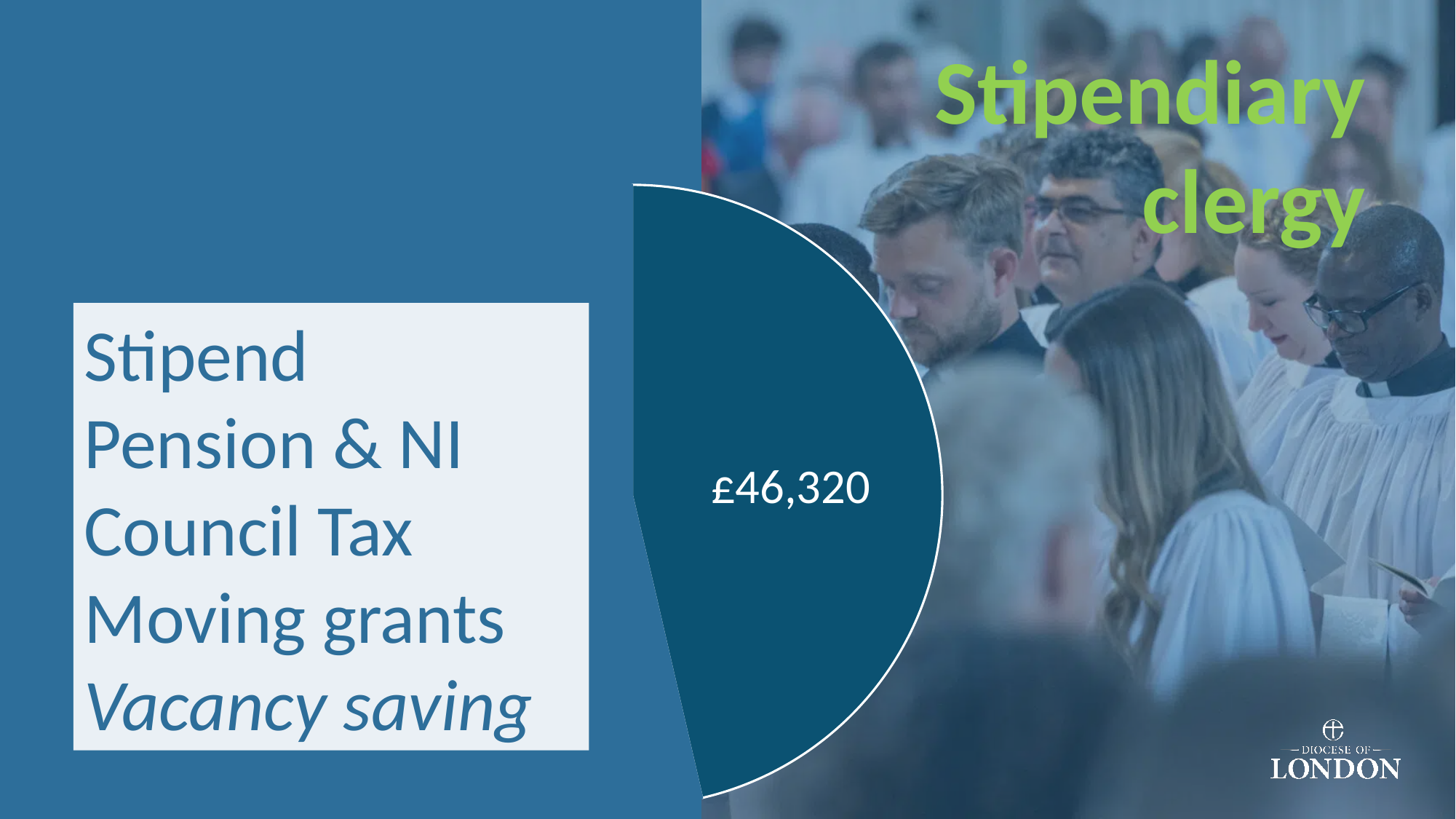
Is the value printed on the pie chart greater or less than £40,000? greater What is the title shown in green text on the slide? Stipendiary clergy How many data labels are printed on the pie chart? 1 What kind of chart is shown on the slide? Pie chart What value is printed on the large slice of the pie chart? £46,320